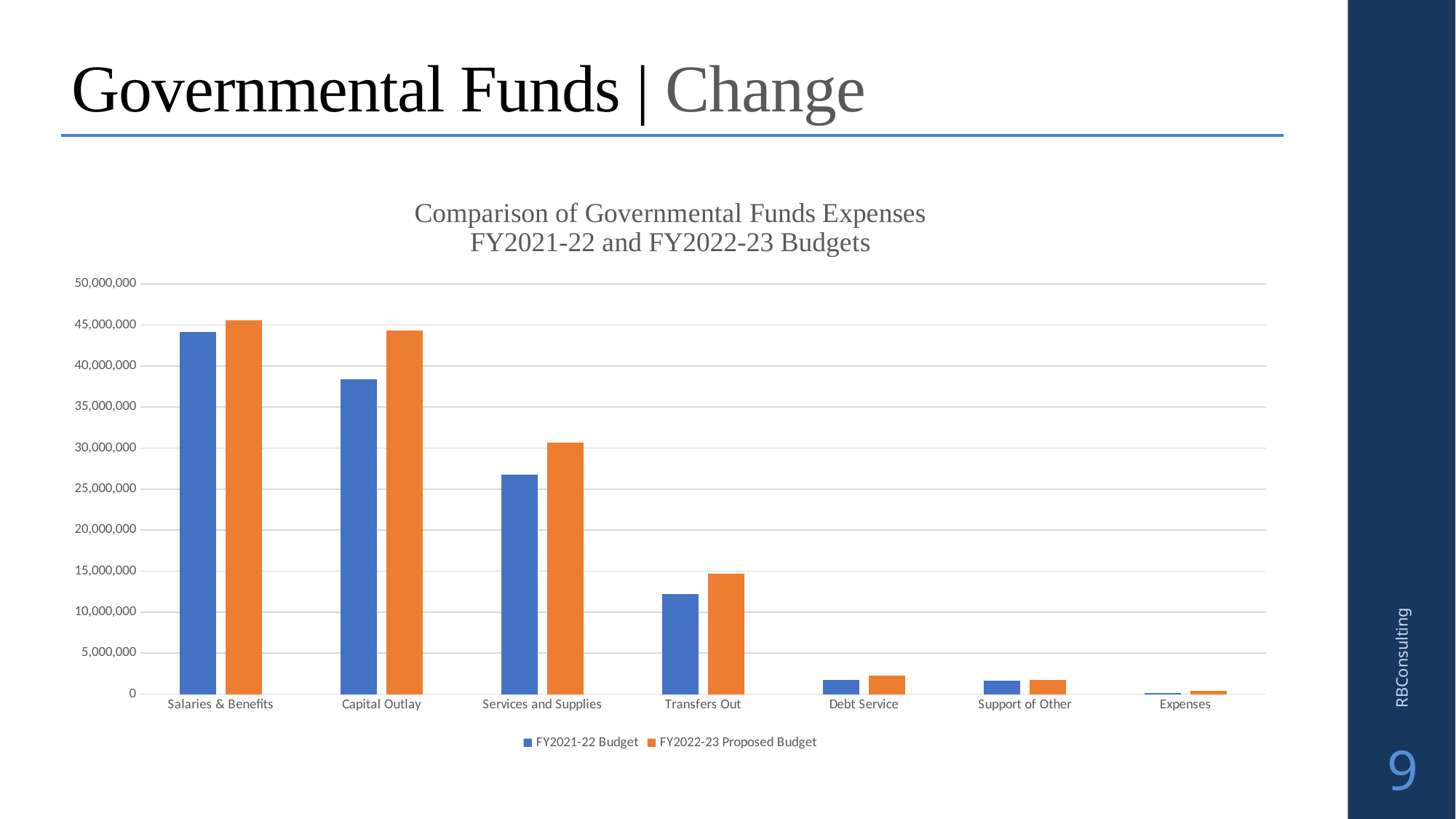
Is the FY2022-23 Proposed Budget value for Services and Supplies greater or less than 25,000,000? greater Is the FY2021-22 Budget value for Capital Outlay greater or less than 35,000,000? greater What kind of chart is shown on the slide? bar chart How many expense categories are shown on the x axis? 7 For Services and Supplies, which is larger: the FY2021-22 Budget or the FY2022-23 Proposed Budget? FY2022-23 Proposed Budget What is the title of the chart? Comparison of Governmental Funds Expenses FY2021-22 and FY2022-23 Budgets For Capital Outlay, which is larger: the FY2021-22 Budget or the FY2022-23 Proposed Budget? FY2022-23 Proposed Budget How many series does the legend list? 2 Is the FY2022-23 Proposed Budget value for Debt Service greater or less than 5,000,000? less Which category has the lowest FY2021-22 Budget value? Expenses Which category has the highest FY2022-23 Proposed Budget value? Salaries & Benefits